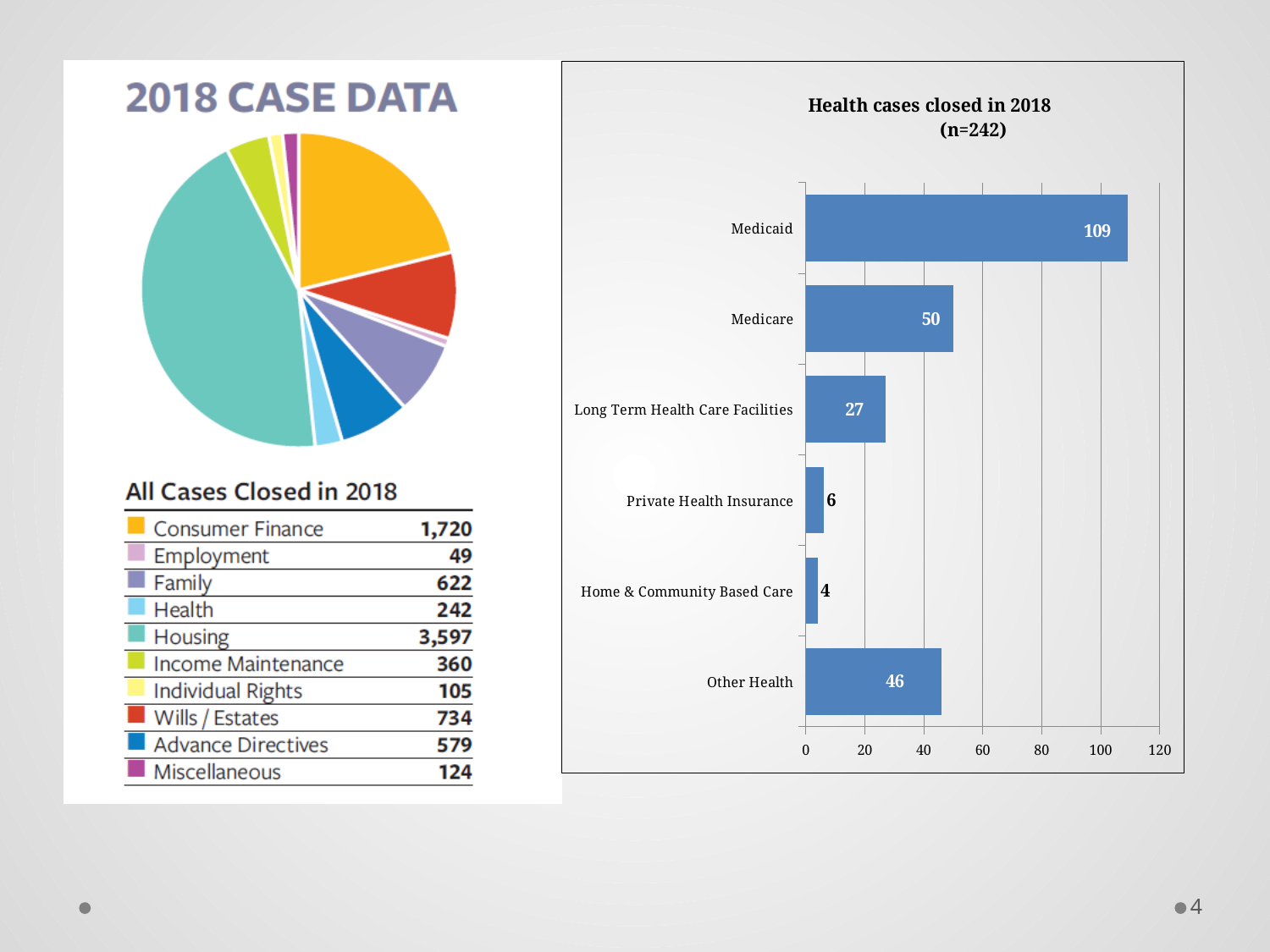
In the 'Health cases closed in 2018' chart, which category has the lowest value? Home & Community Based Care In the '2018 CASE DATA' pie chart, what is the difference between Consumer Finance and Wills / Estates cases? 986 In the 'Health cases closed in 2018' chart, what is the difference between the Medicaid and Medicare values? 59 In the '2018 CASE DATA' pie chart, how many Housing cases were closed in 2018? 3,597 In the 'Health cases closed in 2018' chart, how many cases were closed for Medicaid? 109 In the 'Health cases closed in 2018' chart, how many cases were closed for Long Term Health Care Facilities? 27 What kind of chart is the 'Health cases closed in 2018' chart? Bar chart In the 'Health cases closed in 2018' chart, which is larger: Other Health or Long Term Health Care Facilities? Other Health In the '2018 CASE DATA' pie chart, which category has the smallest number of cases? Employment In the 'Health cases closed in 2018' chart, which category has the highest value? Medicaid In the '2018 CASE DATA' pie chart, how many categories are listed? 10 In the 'Health cases closed in 2018' chart, how many categories are shown? 6